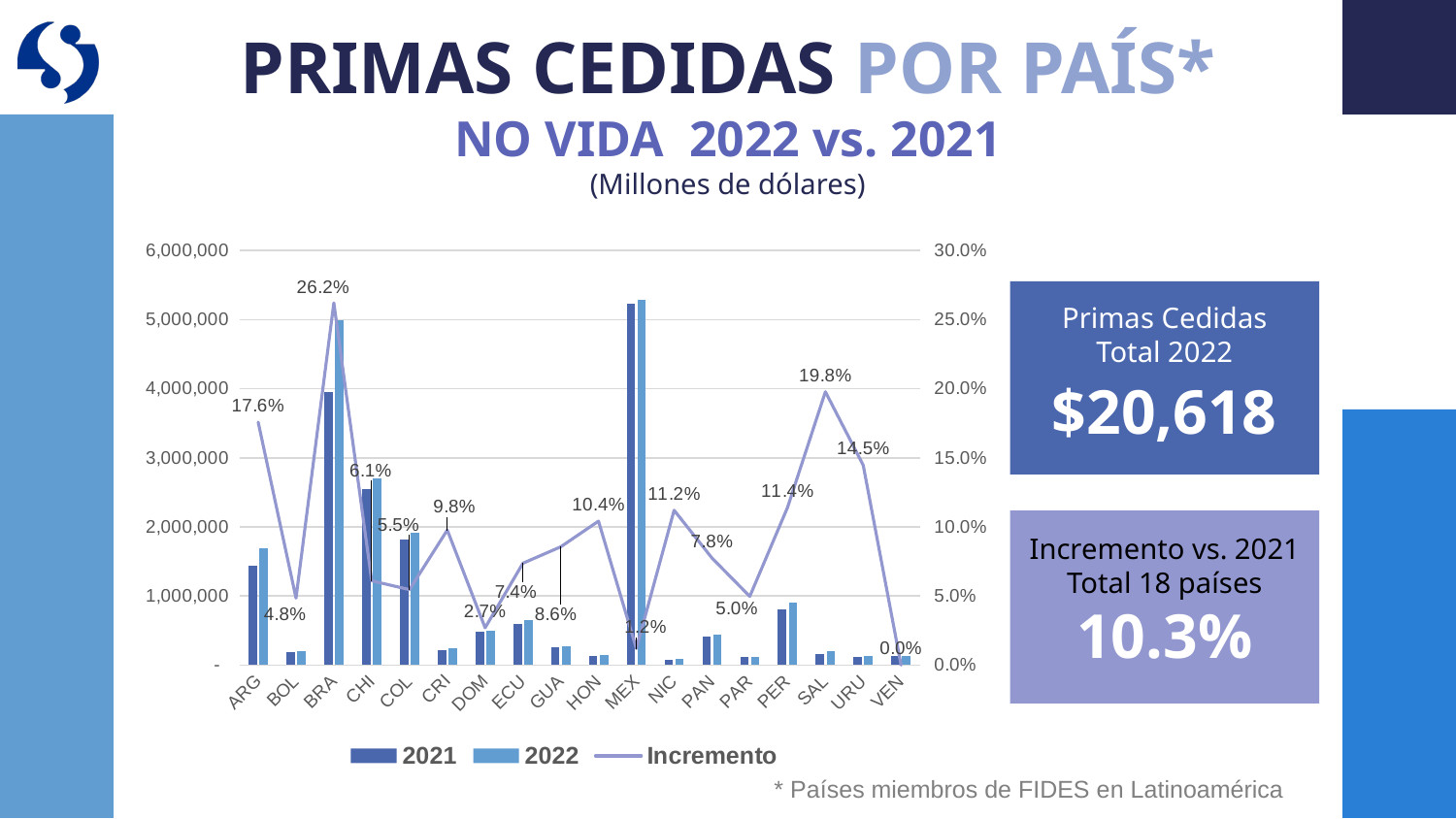
Is the 2021 value for COL greater or less than 2,000,000? less What kind of chart is this? Combination bar and line chart What is the Incremento value for SAL? 19.8% Which country has the highest Incremento? BRA What is the difference in Incremento between BRA and SAL? 6.4 percentage points What is the Incremento value for MEX? 1.2% How many series does the legend list? 3 How many countries are shown on the x axis? 18 What is the Incremento value for BRA? 26.2% Which has a larger Incremento, ARG or URU? ARG Is the 2022 value for MEX greater or less than 5,000,000? greater Which country has the lowest Incremento? VEN